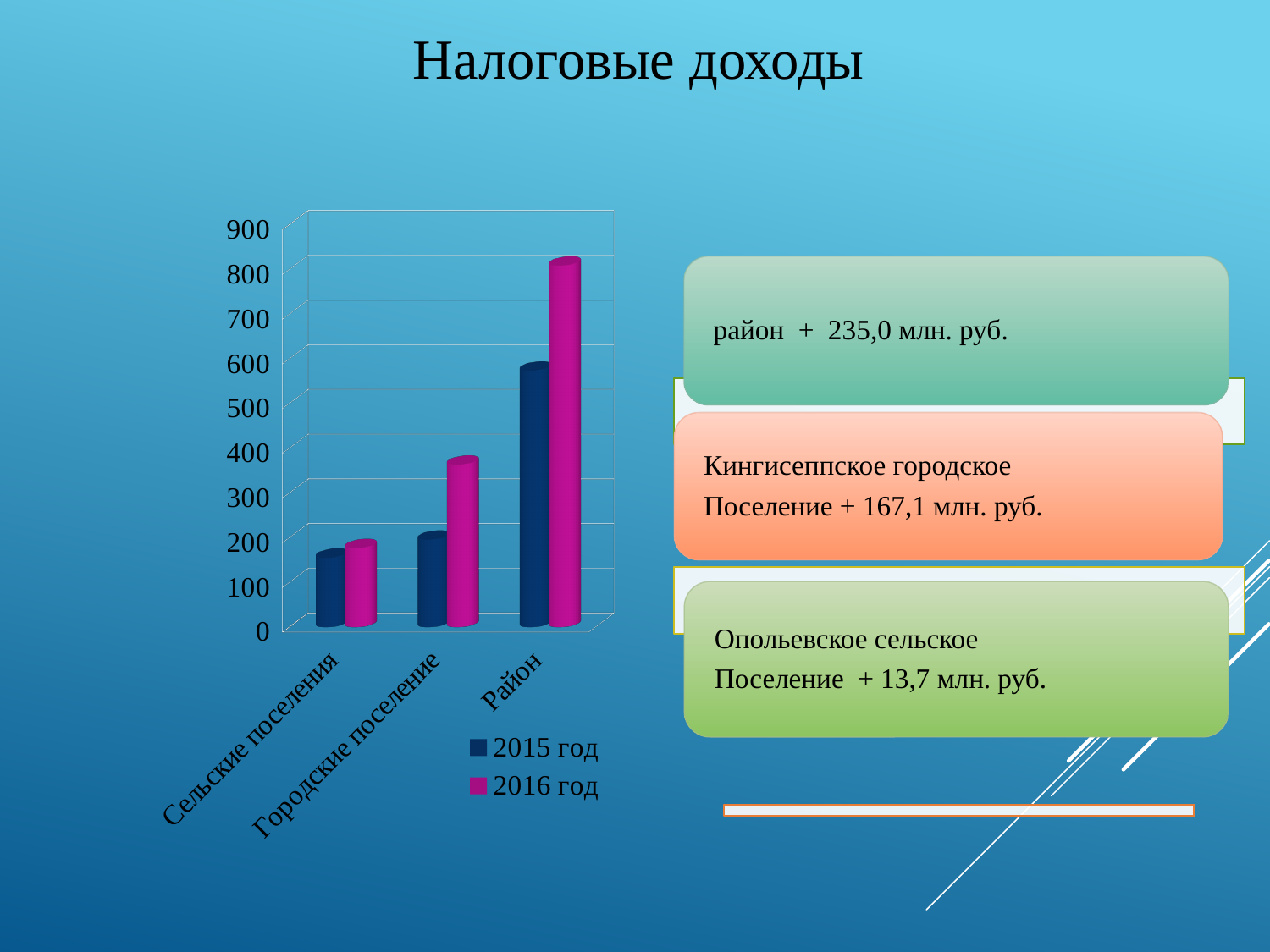
Which is larger: the 2016 год value for Район or the 2016 год value for Городские поселение? Район Which category has the highest value for the 2016 год series? Район Is the 2015 год value for Район greater or less than 500? greater Do the 2016 год values rise or fall moving from Сельские поселения to Район along the x axis? rise What kind of chart is shown on the slide? bar chart How many categories are shown on the x axis of the chart? 3 What is the title of the slide containing the chart? Налоговые доходы Which category has the lowest value for the 2015 год series? Сельские поселения Is the 2015 год value for Сельские поселения greater or less than 200? less Is the 2016 год value for Район greater or less than 700? greater How many series does the chart legend list? 2